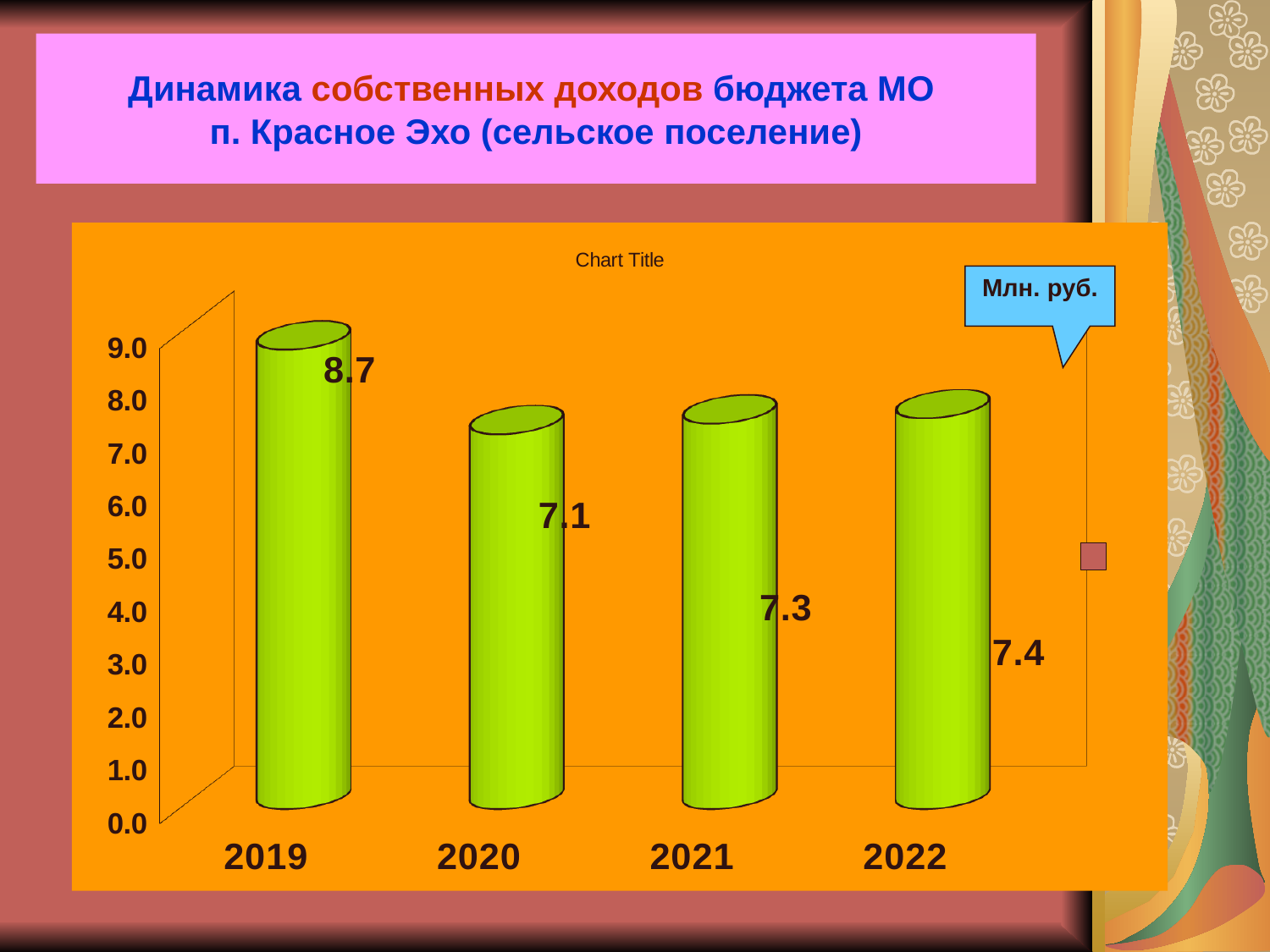
What is the value for 2019? 8.7 Is the value for 2020 greater or less than 8.0? less What is the difference between the values for 2019 and 2020? 1.6 Which year has the highest value? 2019 How many years are shown on the x axis? 4 Which is larger, the value for 2021 or the value for 2022? 2022 What is the value for 2022? 7.4 What kind of chart is shown on the slide? bar chart What unit is indicated in the callout box on the chart? Млн. руб. What is the value for 2021? 7.3 Which year has the lowest value? 2020 What is the value for 2020? 7.1